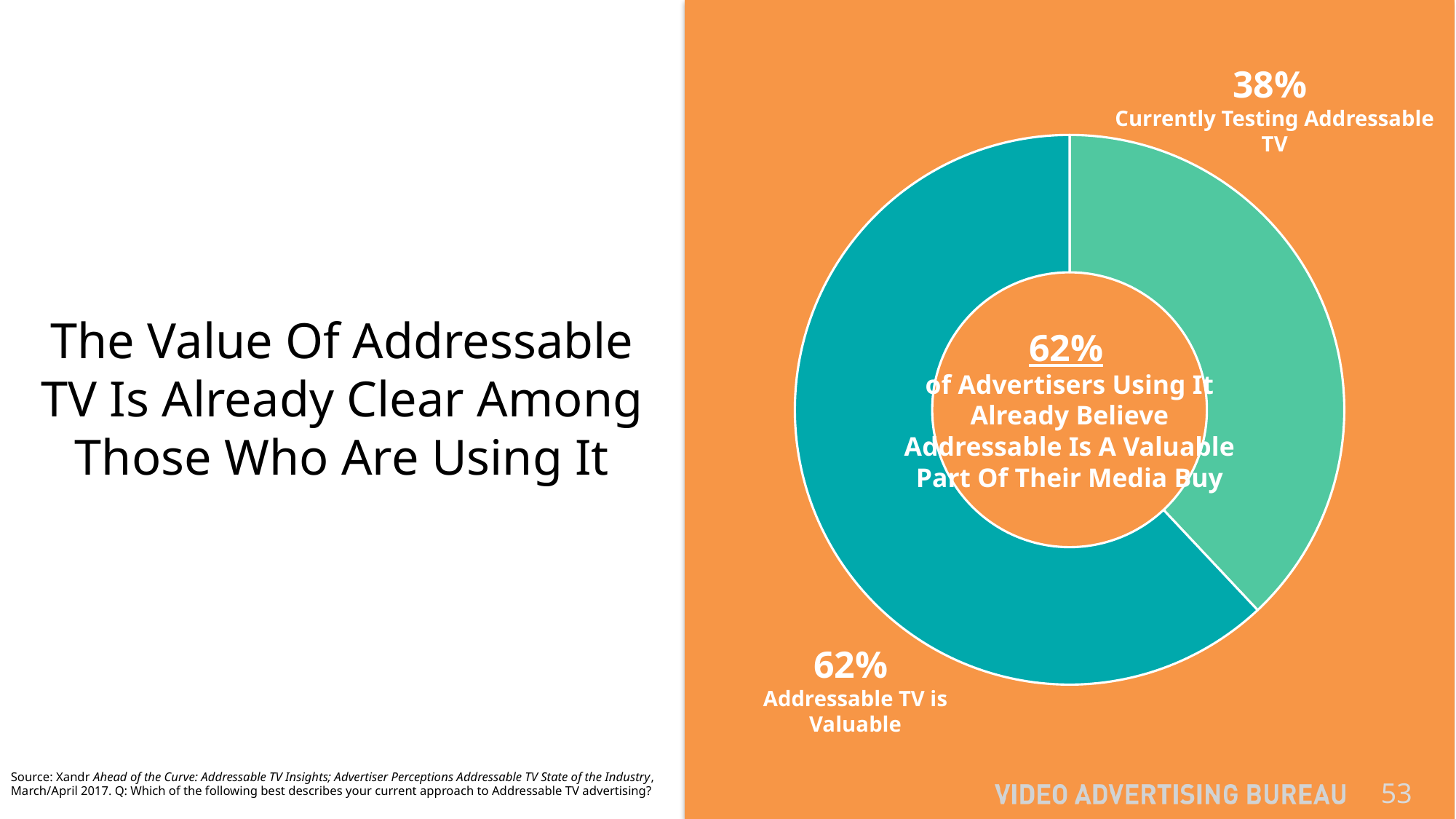
Which segment of the chart is the smallest? Currently Testing Addressable TV Which segment of the chart is the largest? Addressable TV is Valuable What percentage of advertisers are Currently Testing Addressable TV? 38% What percentage is highlighted in the centre of the doughnut chart? 62% What percentage of advertisers say Addressable TV is Valuable? 62% What kind of chart is shown on the slide? Doughnut chart What colour is the Currently Testing Addressable TV segment? Light green What is the total of the two segments shown in the chart? 100% Is the value for Currently Testing Addressable TV greater or less than 50%? less What is the difference in percentage points between the Addressable TV is Valuable segment and the Currently Testing Addressable TV segment? 24 Which segment is larger: Addressable TV is Valuable or Currently Testing Addressable TV? Addressable TV is Valuable How many segments does the chart have? 2